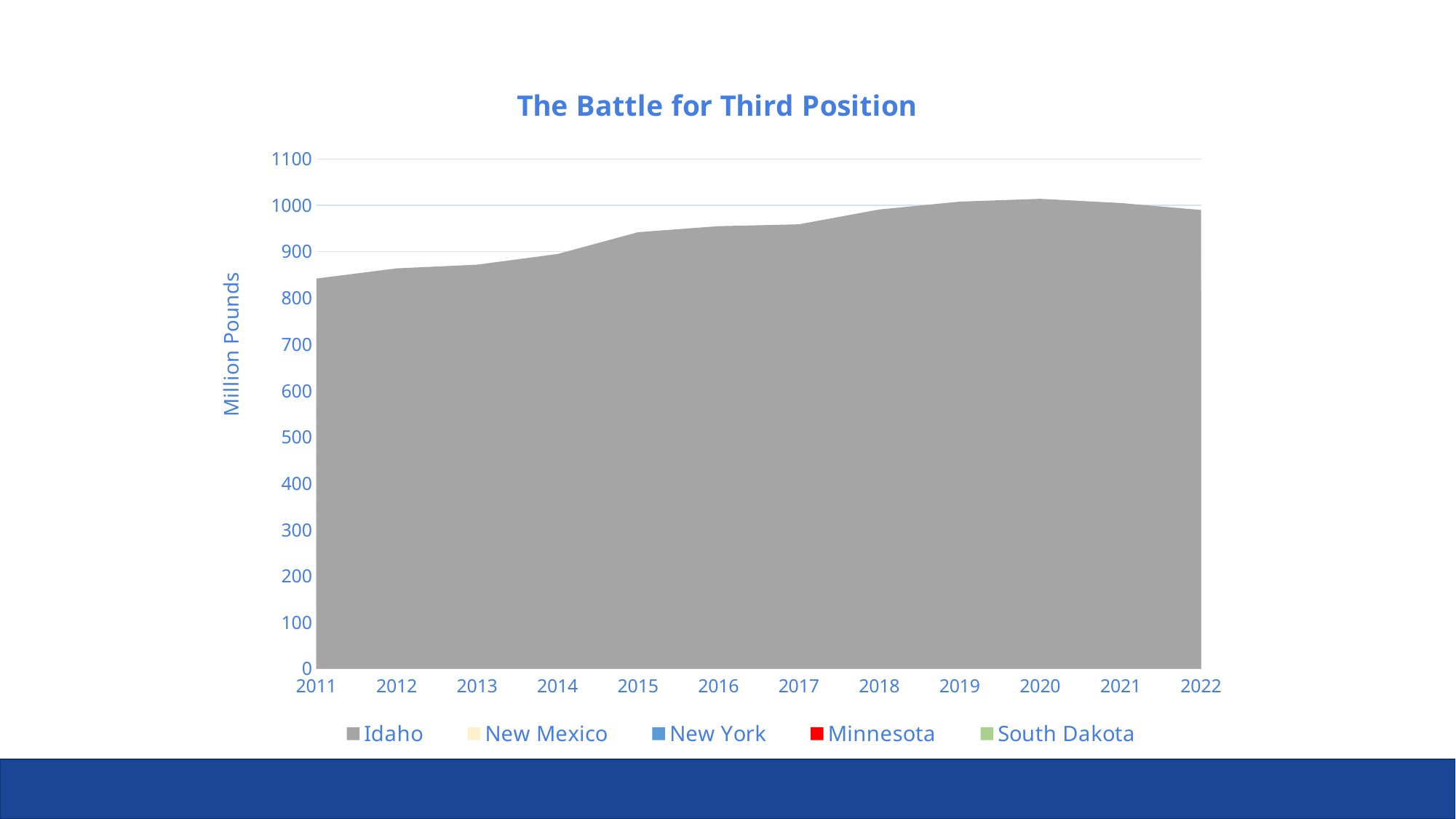
What kind of chart is shown on the slide? Area chart Is the value for Idaho in 2013 greater or less than 1000? less In which year is the Idaho value lowest? 2011 What is the title of the chart? The Battle for Third Position Does the Idaho value generally rise or fall from 2011 to 2020? Rise Is the value for Idaho in 2011 greater or less than 800? greater How many years are shown along the x axis? 12 What is the label on the vertical axis? Million Pounds Is the value for Idaho in 2015 greater or less than 900? greater Which is larger, the Idaho value in 2011 or in 2018? 2018 How many series does the legend list? 5